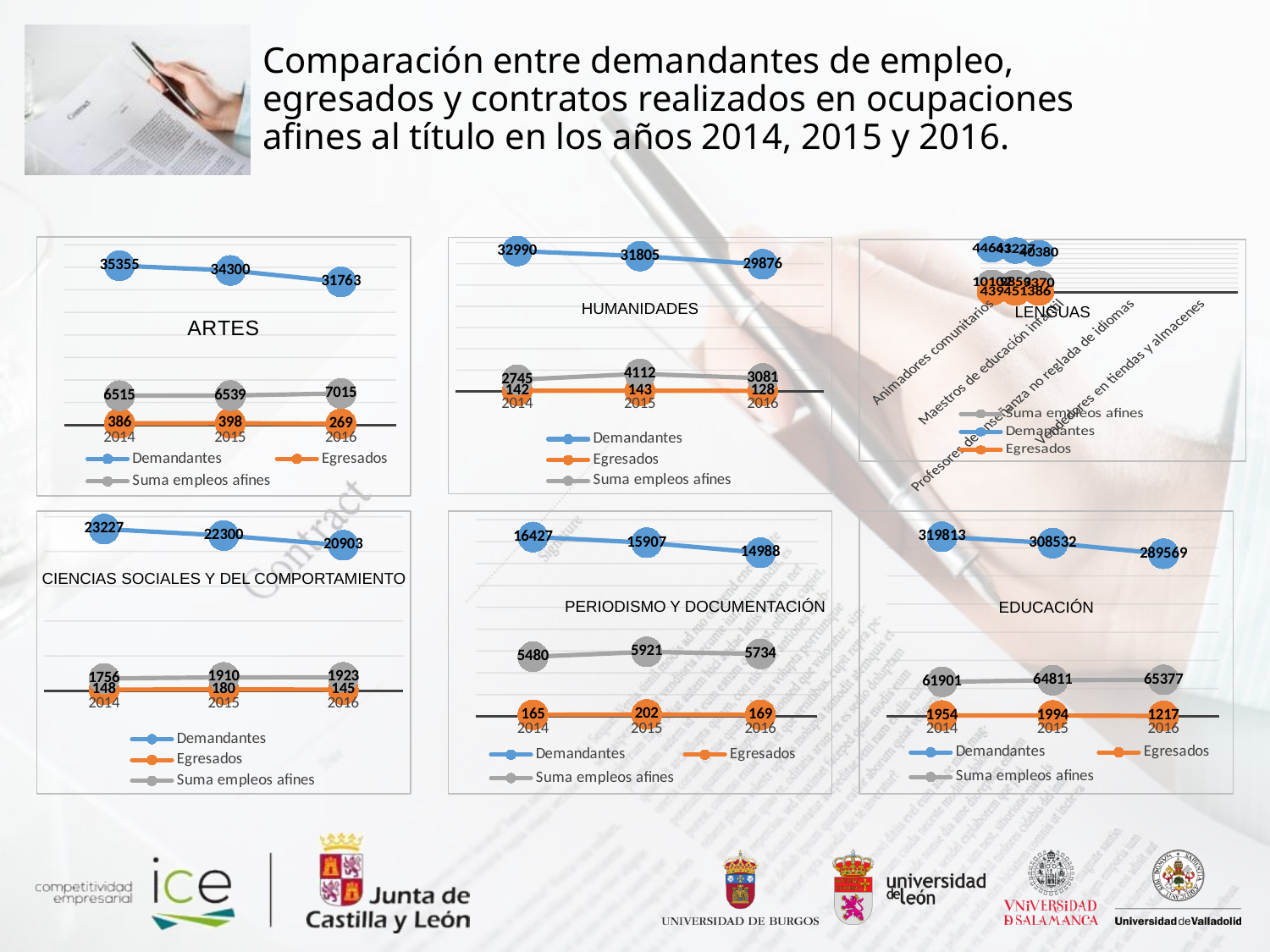
In the HUMANIDADES chart, in which year is Suma empleos afines highest? 2015 In the ARTES chart, what is the value for Demandantes in 2014? 35355 How many series does the legend of the ARTES chart list? 3 In the HUMANIDADES chart, what is the difference between Demandantes in 2014 and 2016? 3114 In the PERIODISMO Y DOCUMENTACIÓN chart, which is larger: Suma empleos afines in 2015 or in 2016? 2015 In the CIENCIAS SOCIALES Y DEL COMPORTAMIENTO chart, what is the value for Suma empleos afines in 2016? 1923 In the CIENCIAS SOCIALES Y DEL COMPORTAMIENTO chart, do the Demandantes values rise or fall from 2014 to 2016? fall In the PERIODISMO Y DOCUMENTACIÓN chart, in which year is Egresados lowest? 2014 In the ARTES chart, what is the value for Egresados in 2016? 269 In the EDUCACIÓN chart, what is the value for Demandantes in 2016? 289569 What kind of chart is the EDUCACIÓN chart? line chart In the EDUCACIÓN chart, what is the difference between Egresados in 2015 and 2016? 777